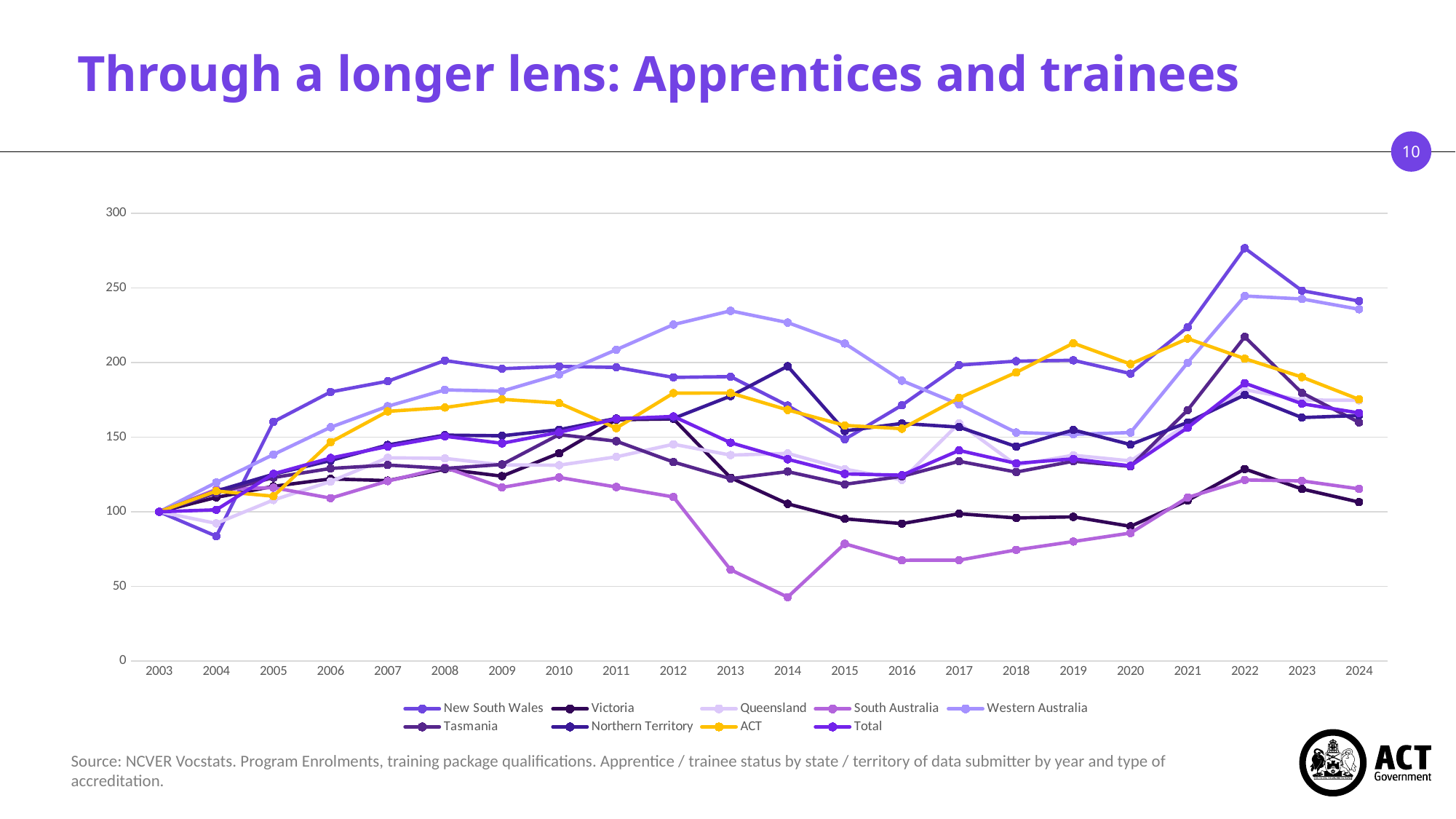
Is the value for New South Wales in 2022 greater or less than 250? greater How many years are shown along the x axis? 22 What kind of chart is shown on the slide? line chart Which series has the highest value in 2022? New South Wales How many series does the legend list? 9 Is the value for Western Australia in 2013 greater or less than 200? greater Is the value for Victoria in 2024 greater or less than 150? less Does the South Australia line rise or fall from 2012 to 2014? fall What is the title of the slide containing the chart? Through a longer lens: Apprentices and trainees Which series has the lowest value in 2014? South Australia What is the value for New South Wales in 2003? 100